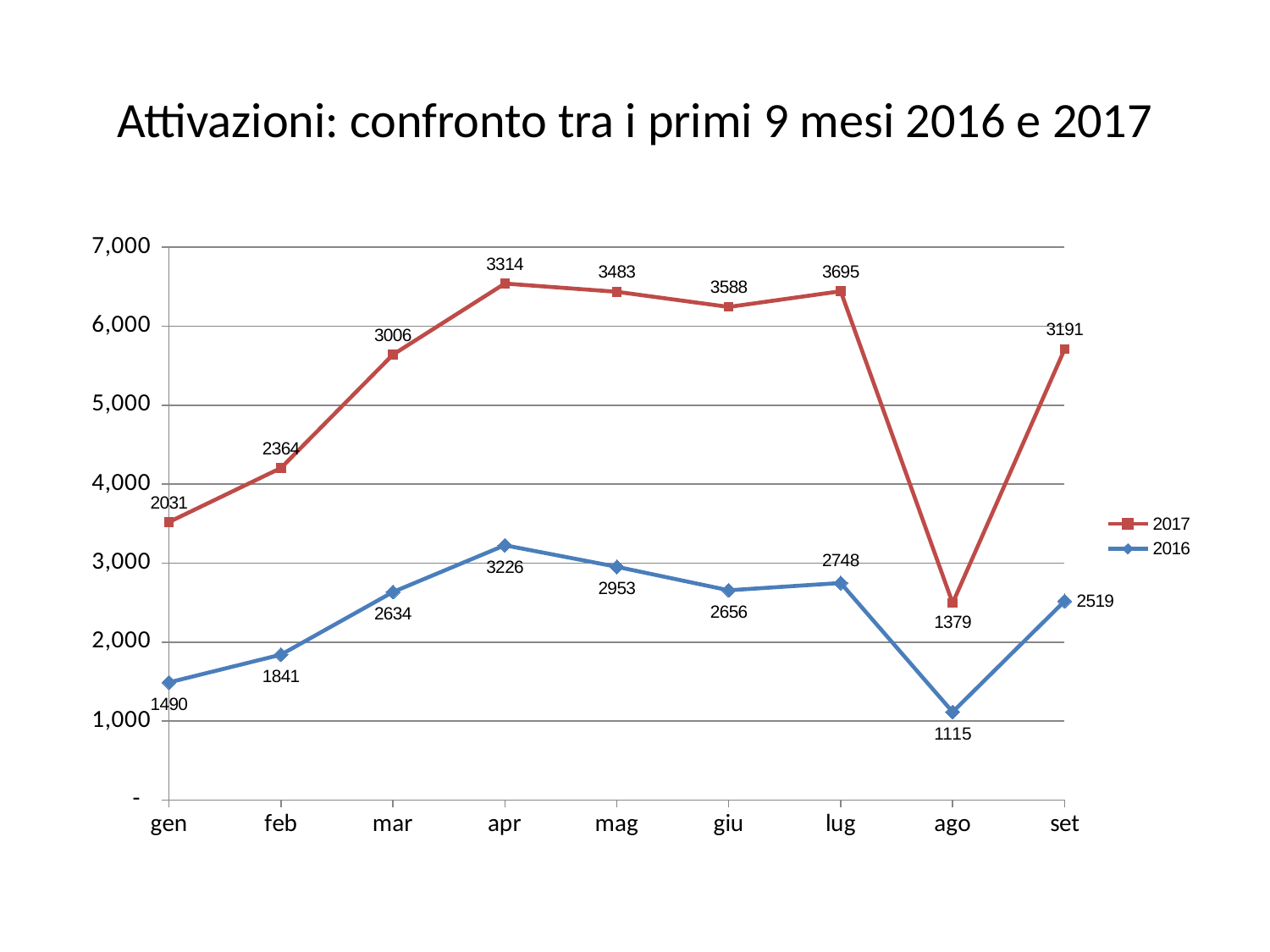
How many series does the legend list? 2 What is the title of the chart? Attivazioni: confronto tra i primi 9 mesi 2016 e 2017 What type of chart is shown on the slide? line chart Does the 2016 series rise or fall from gen to apr? rise Which series has the higher value in mag, 2016 or 2017? 2017 In which month does the 2016 series reach its lowest value? ago What is the labelled value for the 2017 series in apr? 3314 How many months are shown on the x axis? 9 What is the labelled value for the 2016 series in ago? 1115 What is the difference between the labelled 2017 and 2016 values in ago? 264 What is the labelled value for the 2017 series in set? 3191 In which month does the 2016 series reach its highest value? apr